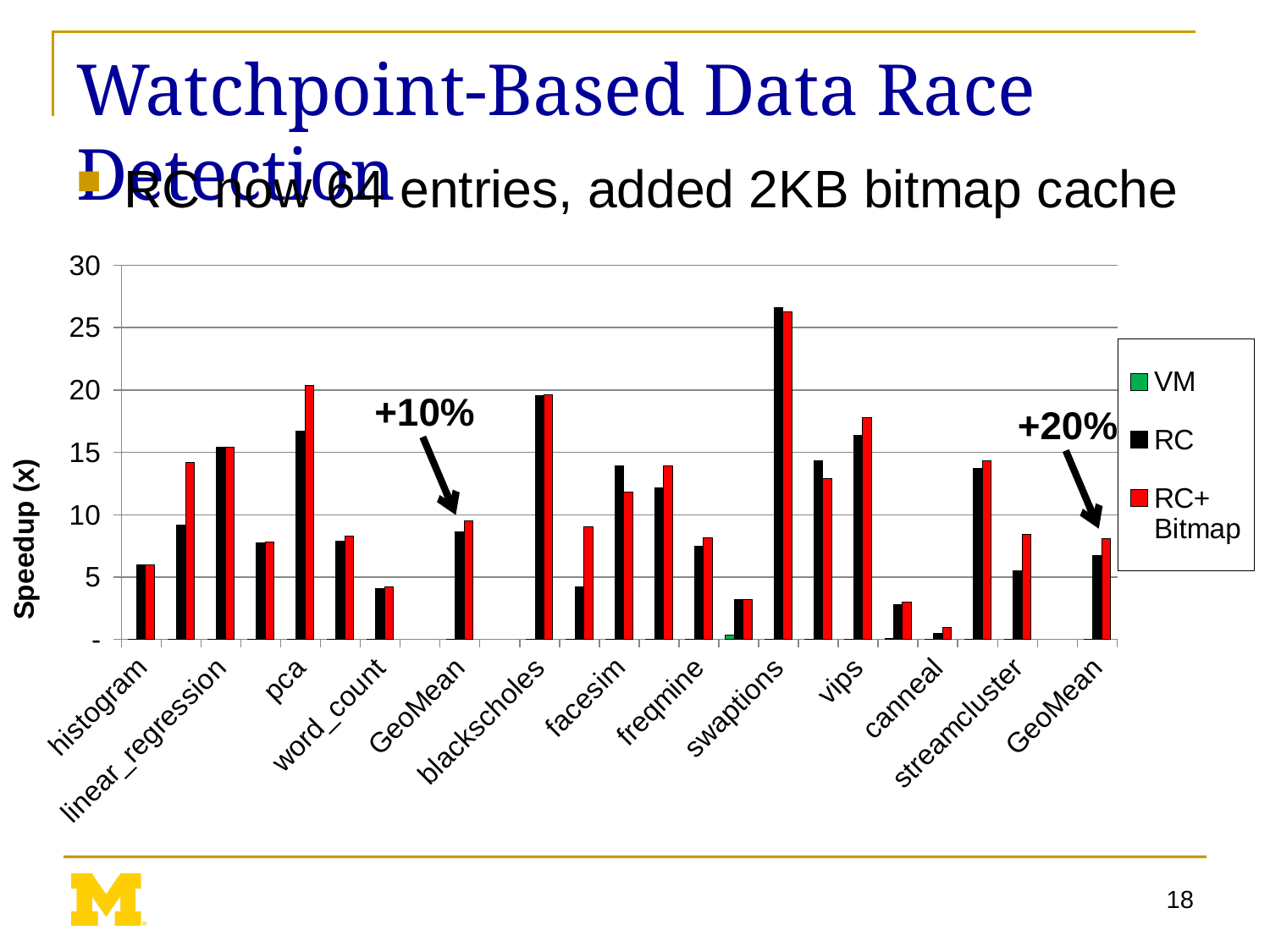
What is the label on the y axis of the chart? Speedup (x) Is the RC+Bitmap value for streamcluster greater or less than 10? less Is the RC value for swaptions greater or less than 25? greater Which category has the lowest RC bar? canneal For facesim, which is larger: the RC bar or the RC+Bitmap bar? RC How many series does the legend list? 3 Which category has the highest RC bar? swaptions Is the RC+Bitmap value for histogram greater or less than 10? less What kind of chart is shown on the slide? bar chart For pca, which is larger: the RC bar or the RC+Bitmap bar? RC+Bitmap